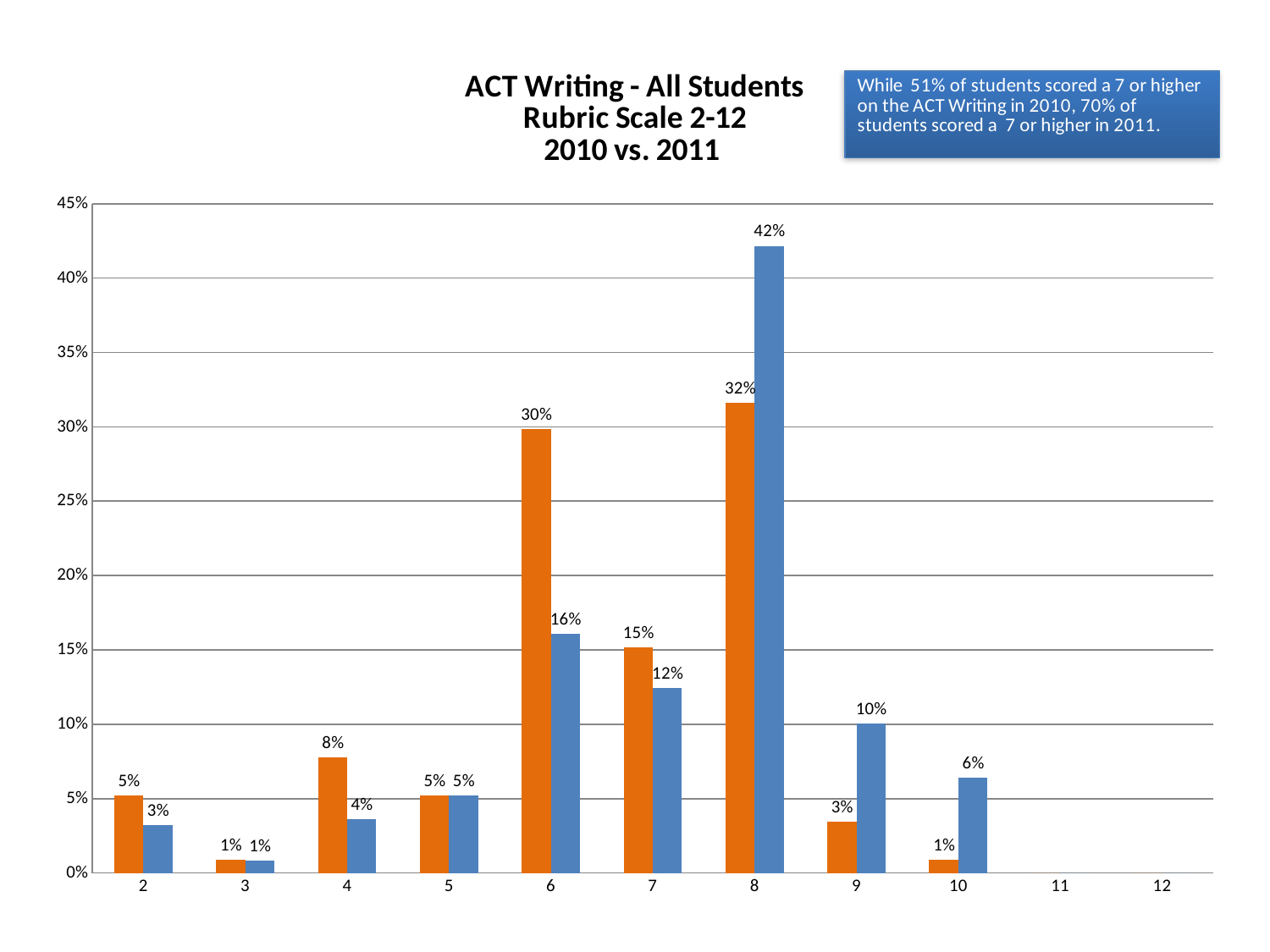
Is the value of the orange bar for score 7 greater or less than 10%? greater What is the value of the orange bar for score 10? 1% At score 9, which bar is larger, the orange or the blue? blue At score 6, how much larger is the orange bar than the blue bar? 14% What type of chart is shown on the slide? bar chart What is the value of the orange bar for score 6? 30% What is the value of the blue bar for score 8? 42% Which score has the lowest blue bar among the scores with bars? 3 Which score has the tallest orange bar? 8 Which score has the tallest blue bar? 8 At score 8, how much larger is the blue bar than the orange bar? 10% How many score categories are shown on the x axis? 11